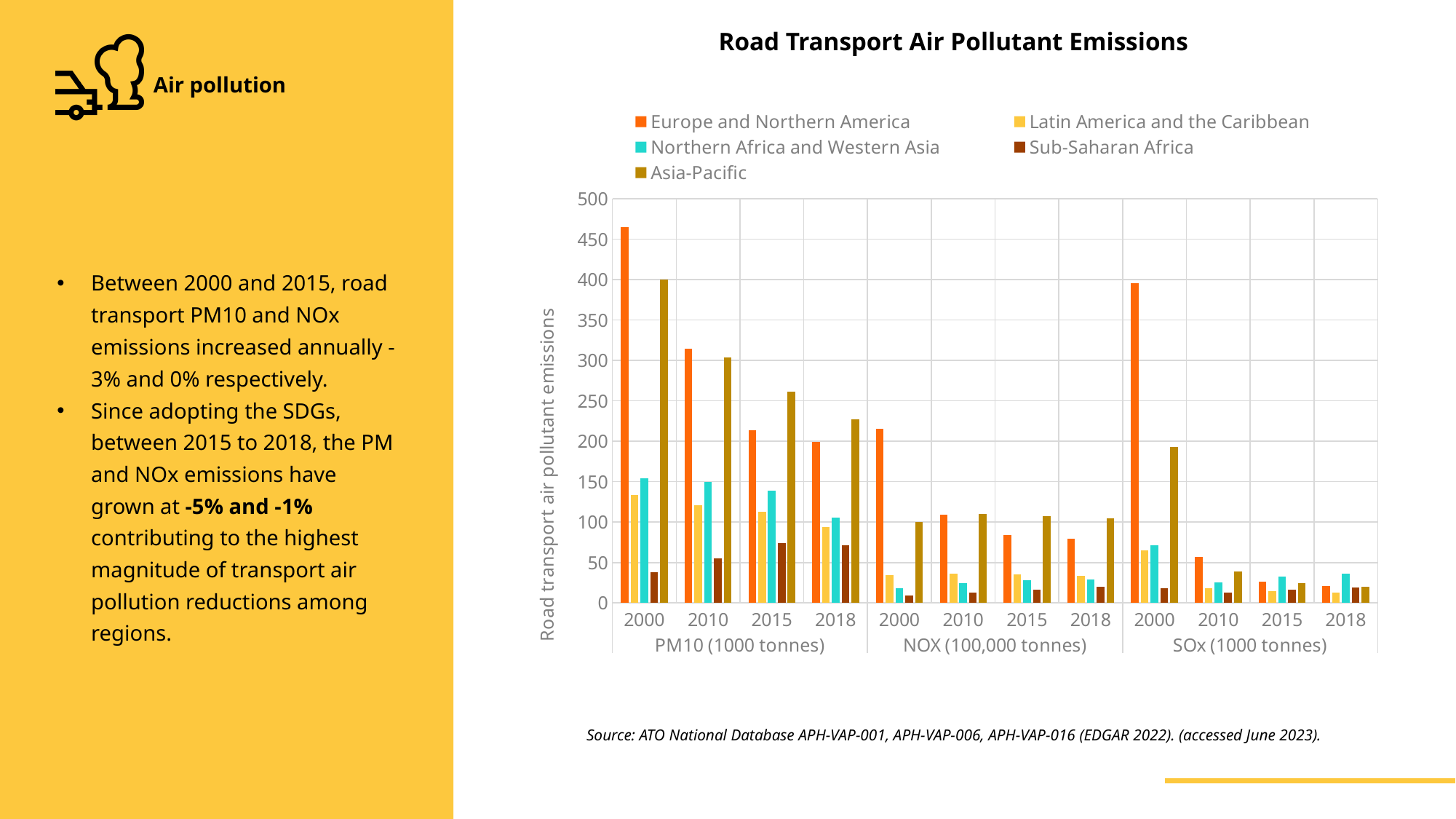
How many pollutant groups are shown along the x axis of the chart? 3 Which region has the highest PM10 (1000 tonnes) value in 2000? Europe and Northern America In SOx (1000 tonnes) for 2000, which is larger: Europe and Northern America or Asia-Pacific? Europe and Northern America Is the value for Europe and Northern America in PM10 (1000 tonnes) for 2000 greater or less than 400? greater Do the PM10 (1000 tonnes) values for Europe and Northern America rise or fall from 2000 to 2018? fall What is the title of the chart? Road Transport Air Pollutant Emissions What kind of chart is shown on the slide? bar chart Is the value for Europe and Northern America in SOx (1000 tonnes) for 2000 greater or less than 350? greater How many series does the legend of the chart list? 5 Is the value for Asia-Pacific in PM10 (1000 tonnes) for 2000 greater or less than 450? less Which region has the lowest NOX (100,000 tonnes) value in 2000? Sub-Saharan Africa Do the PM10 (1000 tonnes) values for Sub-Saharan Africa rise or fall from 2000 to 2015? rise